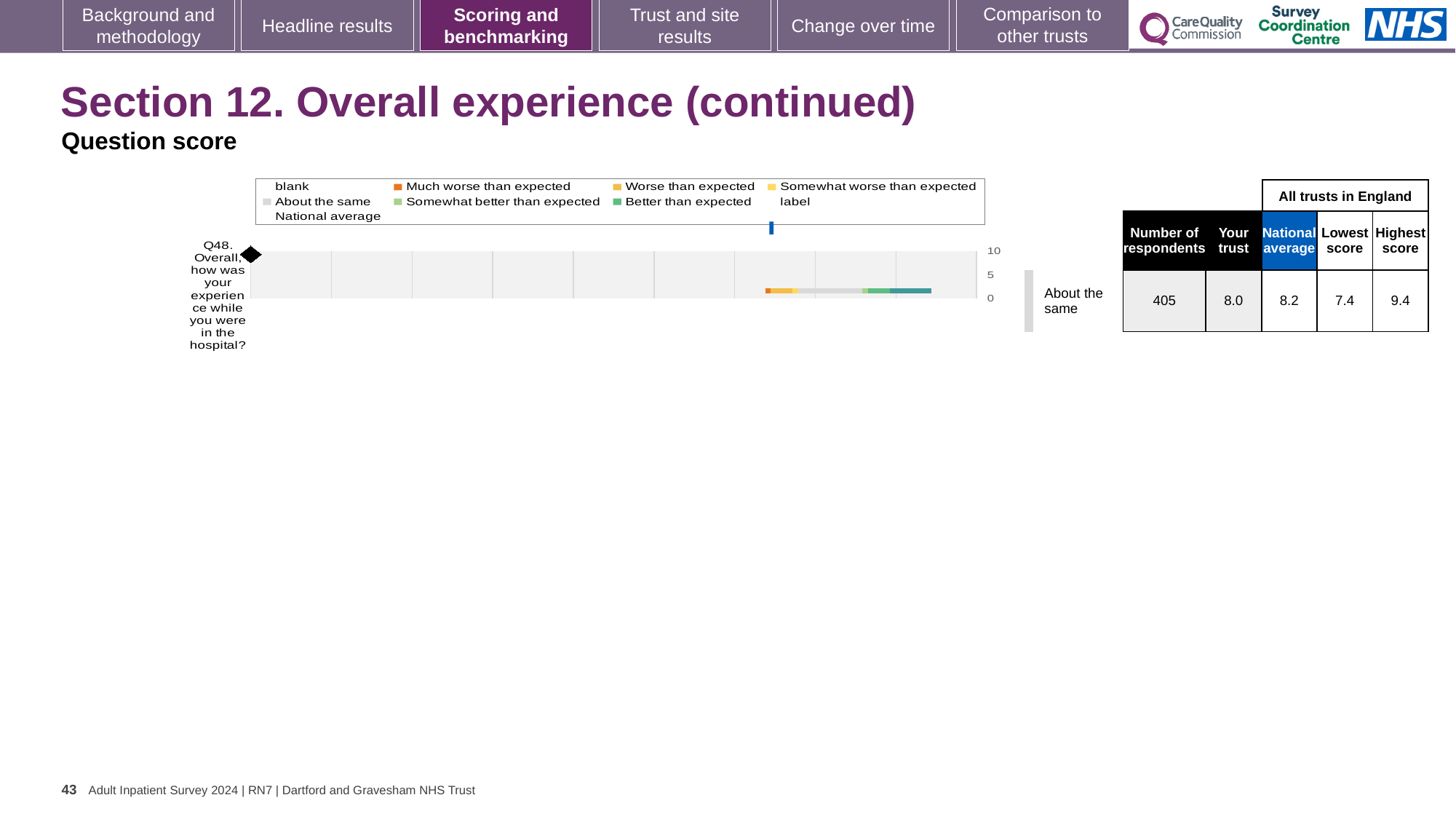
What is the lowest score among all trusts in England for Q48? 7.4 What is the number of respondents for Q48? 405 What is the highest score among all trusts in England for Q48? 9.4 How many entries does the chart legend list? 9 How many questions (categories) are plotted on the chart? 1 Which is larger for Q48, the 'Your trust' score or the national average? National average Which question is plotted on the chart? Q48. Overall, how was your experience while you were in the hospital? What is the highest value shown on the chart's axis? 10 What is the difference between the highest and lowest scores among all trusts in England for Q48? 2.0 What kind of chart is shown on the slide? bar chart What is the national average score for Q48 shown next to the chart? 8.2 What is the 'Your trust' score for Q48 shown next to the chart? 8.0